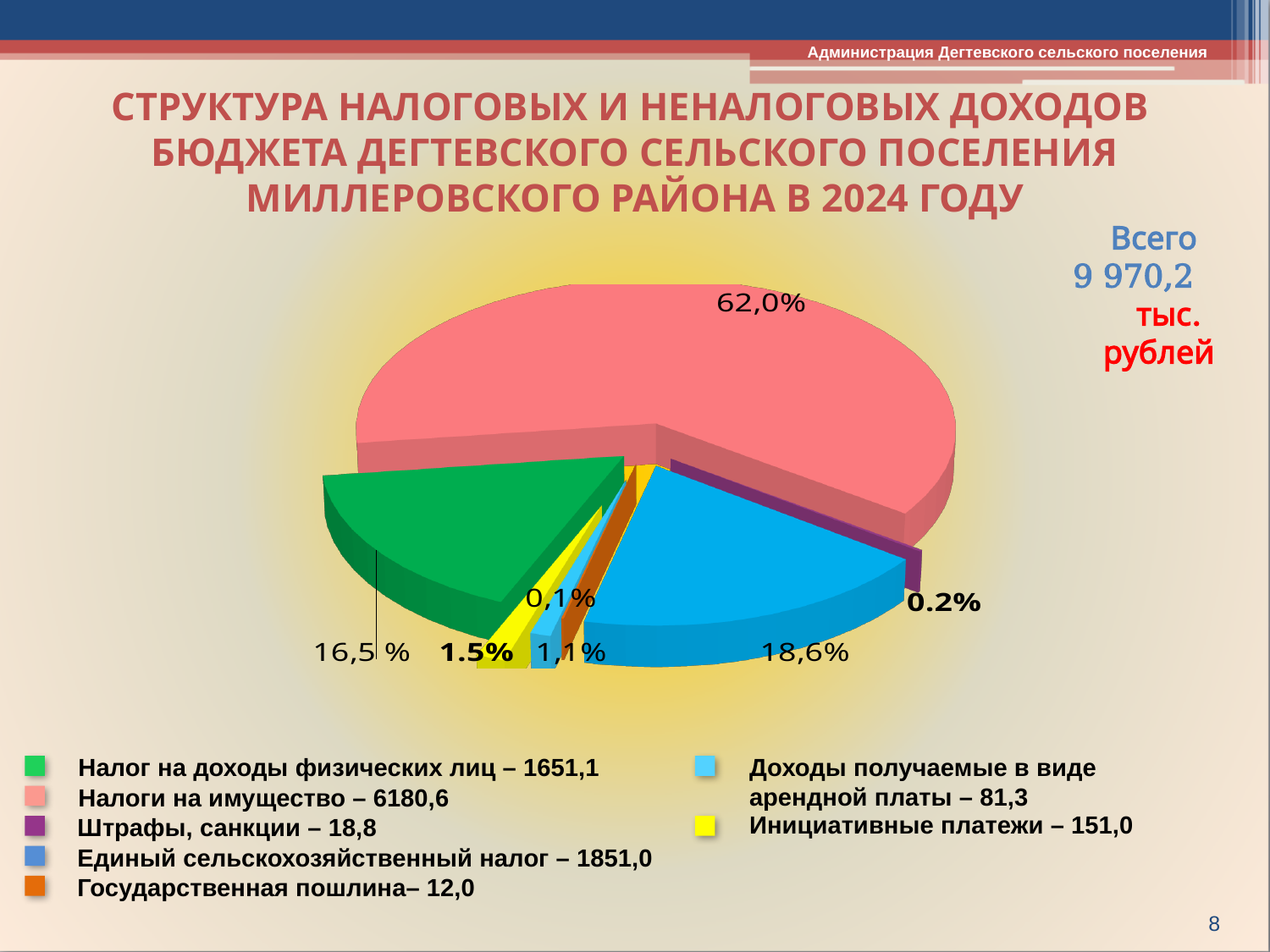
What value is given in the legend for "Инициативные платежи"? 151,0 What percentage is shown for "Единый сельскохозяйственный налог"? 18,6% How many categories does the legend list? 7 What value is given in the legend for "Штрафы, санкции"? 18,8 Which category has the smallest slice of the pie? Государственная пошлина What percentage is shown for "Налог на доходы физических лиц"? 16,5 % Which category has the largest slice of the pie? Налоги на имущество What total amount ("Всего") is stated on the slide? 9 970,2 тыс. рублей Which has the larger share: "Единый сельскохозяйственный налог" or "Налог на доходы физических лиц"? Единый сельскохозяйственный налог What share of the pie does "Налоги на имущество" account for? 62,0% What kind of chart is shown on the slide? Pie chart By how many percentage points does the share of "Налоги на имущество" exceed that of "Единый сельскохозяйственный налог"? 43,4